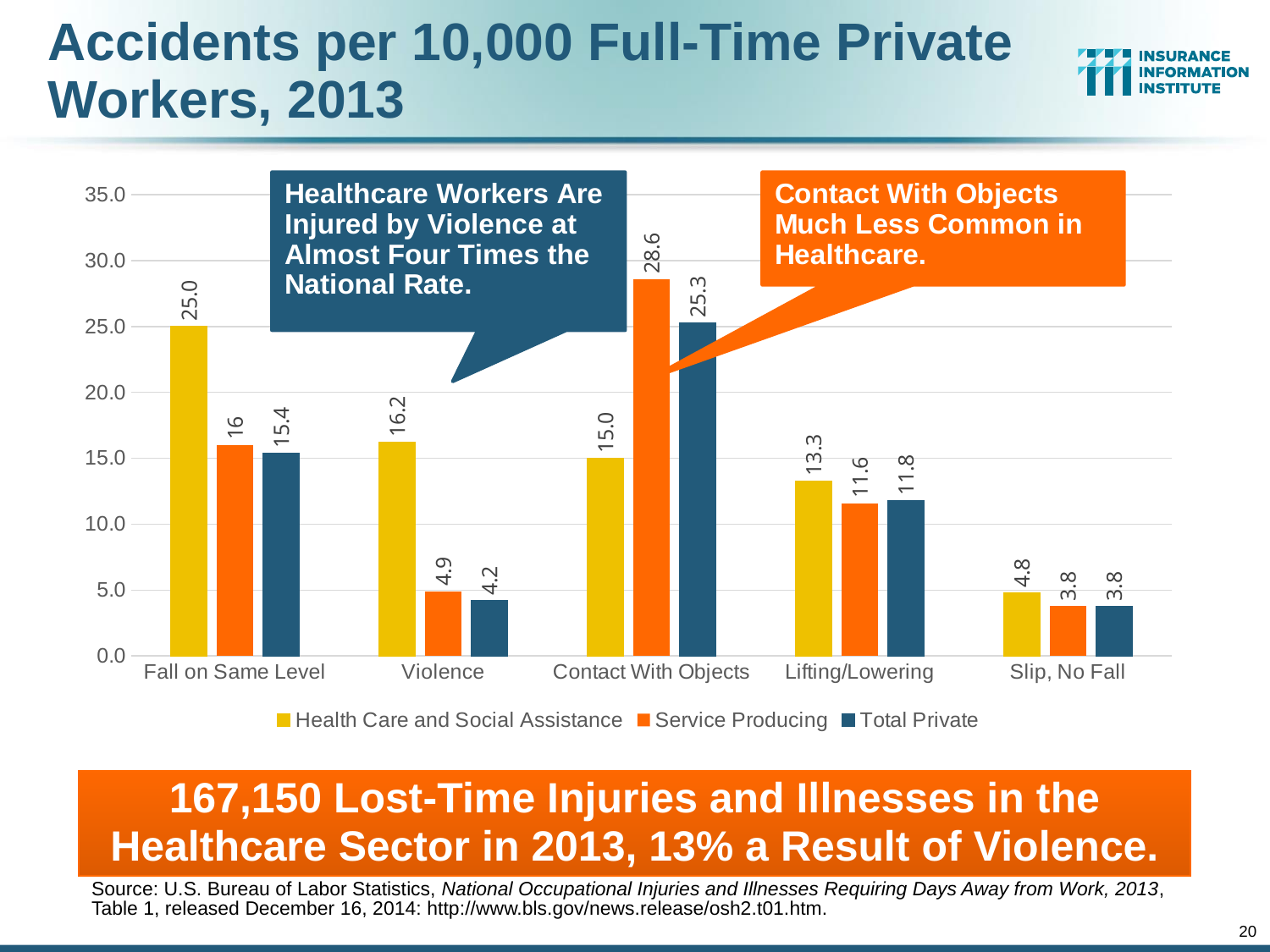
What is the value for Health Care and Social Assistance in the Lifting/Lowering category? 13.3 How many series does the legend list? 3 Which category has the highest value for Health Care and Social Assistance? Fall on Same Level Which category has the lowest value for Service Producing? Slip, No Fall How many categories are shown on the x axis? 5 What is the value for Service Producing in the Contact With Objects category? 28.6 Which series is shown in orange in the legend? Service Producing What kind of chart is shown on the slide? Bar chart In the Contact With Objects category, which is larger: Service Producing or Health Care and Social Assistance? Service Producing What is the value for Total Private in the Violence category? 4.2 What is the difference between the Health Care and Social Assistance value and the Total Private value in the Violence category? 12.0 What is the value for Health Care and Social Assistance in the Fall on Same Level category? 25.0